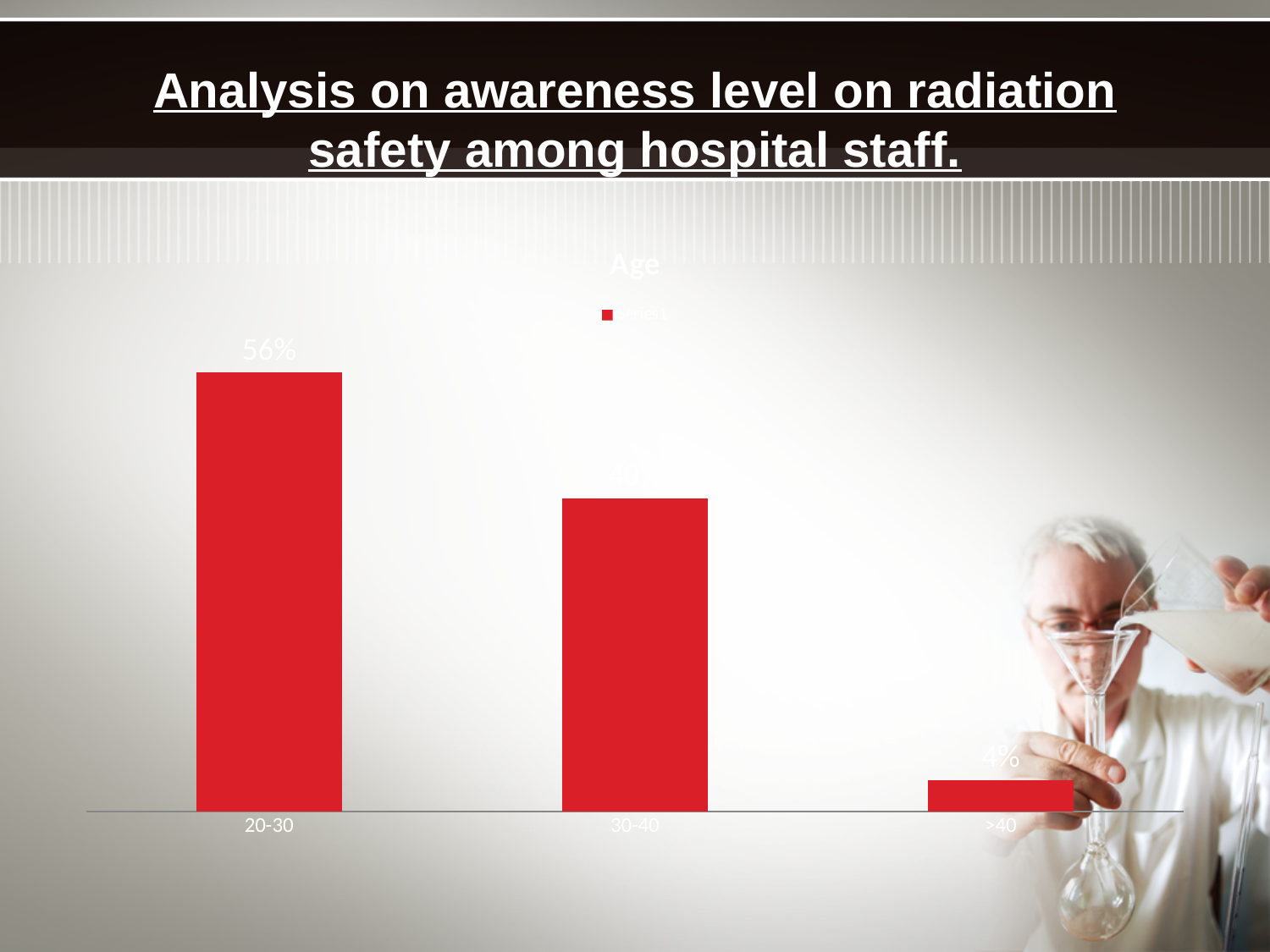
What kind of chart is shown on the slide? Bar chart Which age group has the highest value? 20-30 What is the difference between the values for the 20-30 and >40 age groups? 52% Do the values rise or fall from the 20-30 group to the >40 group? Fall Which has the larger value, the 20-30 group or the 30-40 group? 20-30 What is the value for the >40 age group? 4% Which age group has the lowest value? >40 What is the value for the 20-30 age group? 56% How many age groups are shown on the chart? 3 What is the title of the chart? Age Which has the larger value, the 30-40 group or the >40 group? 30-40 What colour are the bars in the chart? Red